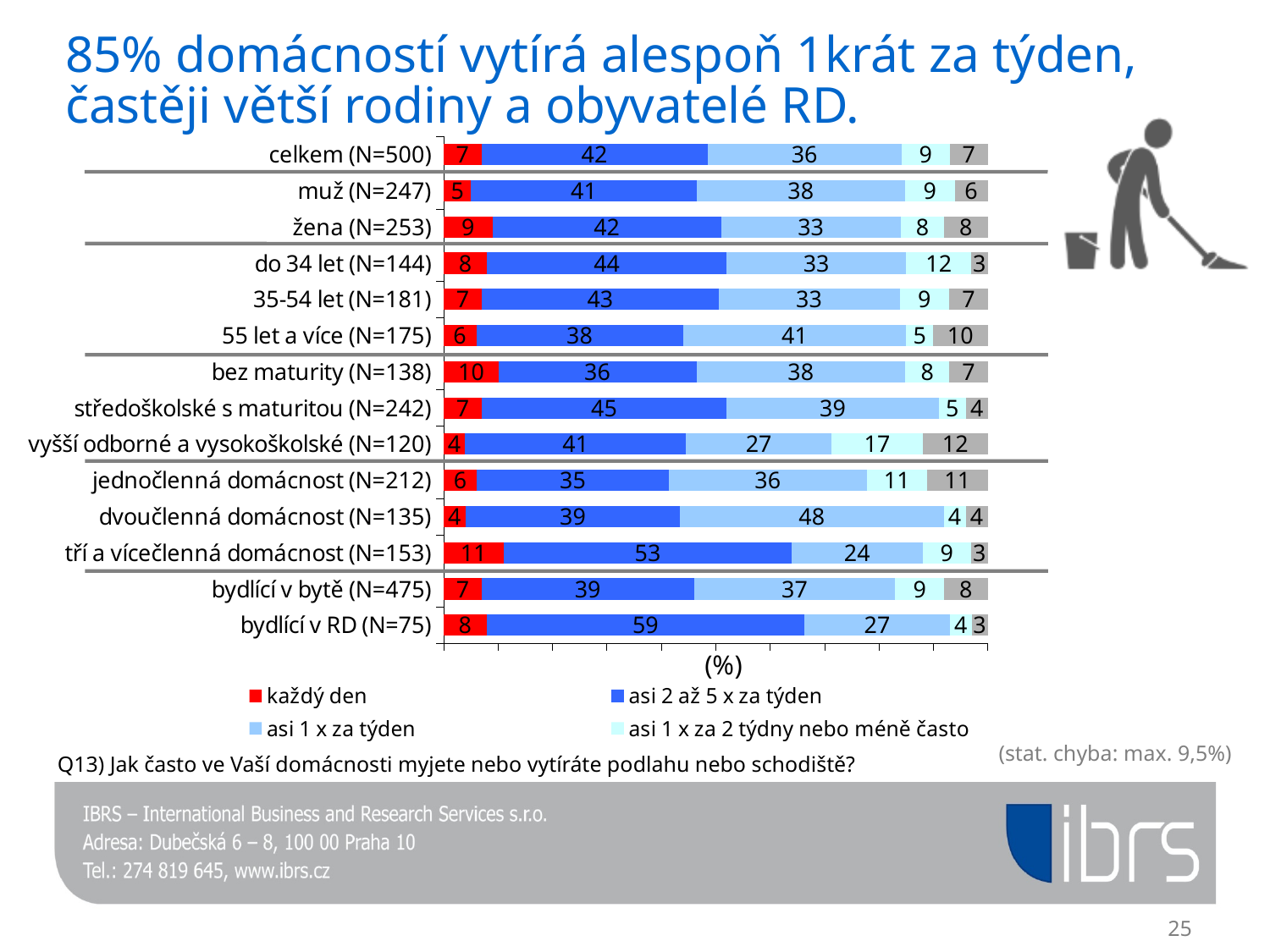
What is the value of 'každý den' for 'bez maturity (N=138)'? 10 What is the first legend entry of the chart? každý den Which is larger: the 'asi 1 x za týden' value for '55 let a více (N=175)' or for 'do 34 let (N=144)'? 55 let a více (N=175) What is the difference between the 'asi 2 až 5 x za týden' values for 'bydlící v RD (N=75)' and 'bydlící v bytě (N=475)'? 20 How many categories (rows) does the chart show? 14 Which category has the highest value for 'každý den'? tří a vícečlenná domácnost (N=153) What kind of chart is shown on the slide? stacked bar chart What is the value of 'asi 1 x za 2 týdny nebo méně často' for 'vyšší odborné a vysokoškolské (N=120)'? 17 How many series does the legend list? 4 What is the value of 'asi 1 x za týden' for 'dvoučlenná domácnost (N=135)'? 48 Which category has the highest value for 'asi 2 až 5 x za týden'? bydlící v RD (N=75) What is the value of 'asi 2 až 5 x za týden' for 'celkem (N=500)'? 42